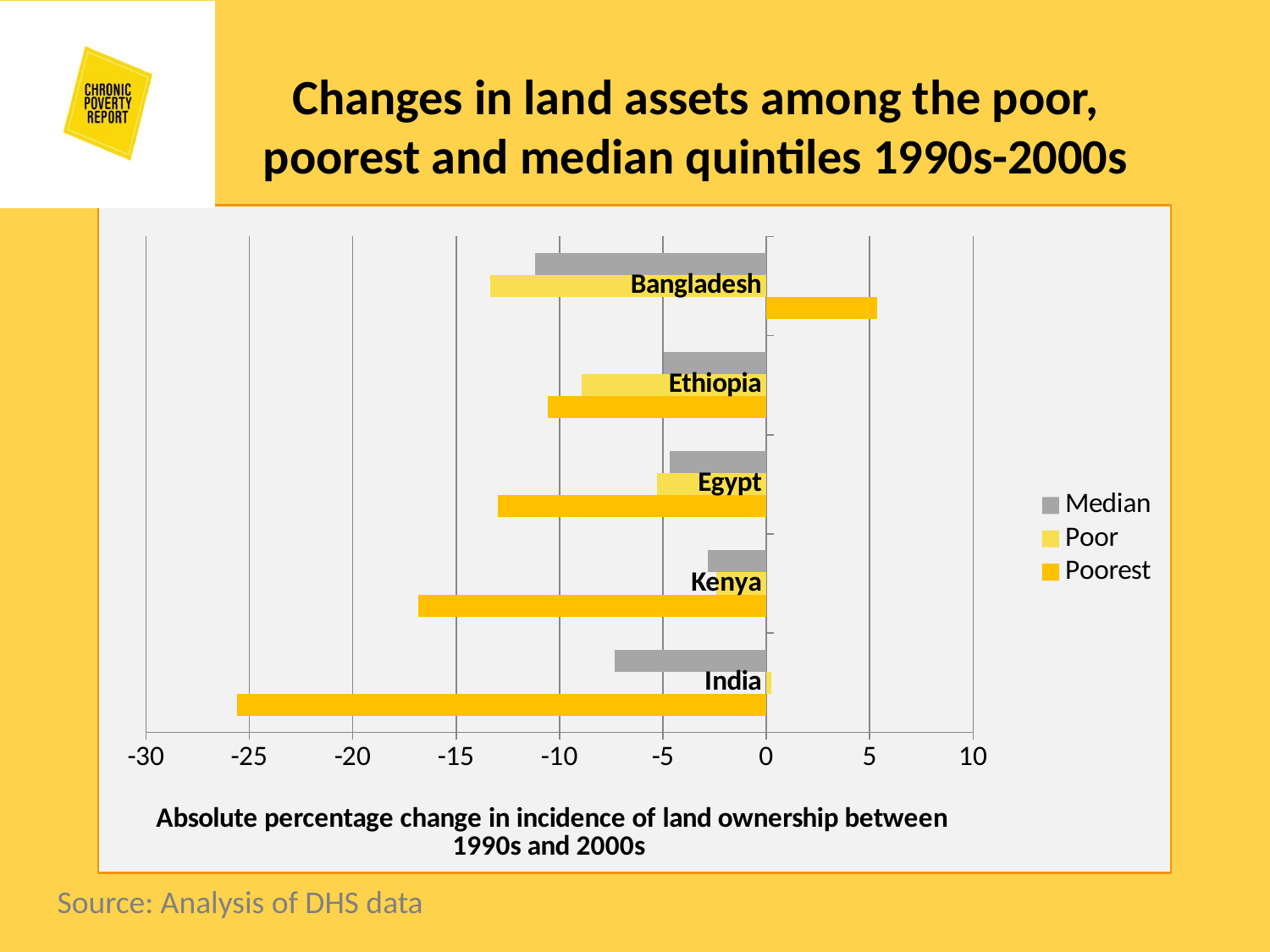
Is the Median value for Bangladesh greater or less than -10? less What is the title of the horizontal axis? Absolute percentage change in incidence of land ownership between 1990s and 2000s Which is larger, the Median value for Kenya or the Median value for India? Kenya Which country has the lowest value for the Poorest series? India What kind of chart is shown on the slide? Bar chart Is the Poorest value for India greater or less than -25? less Which country has the highest value for the Poorest series? Bangladesh How many series does the legend list? 3 Is the Poorest value for Bangladesh greater or less than 5? greater How many countries are shown on the chart? 5 Which is larger, the Poor value for Bangladesh or the Poor value for Egypt? Egypt